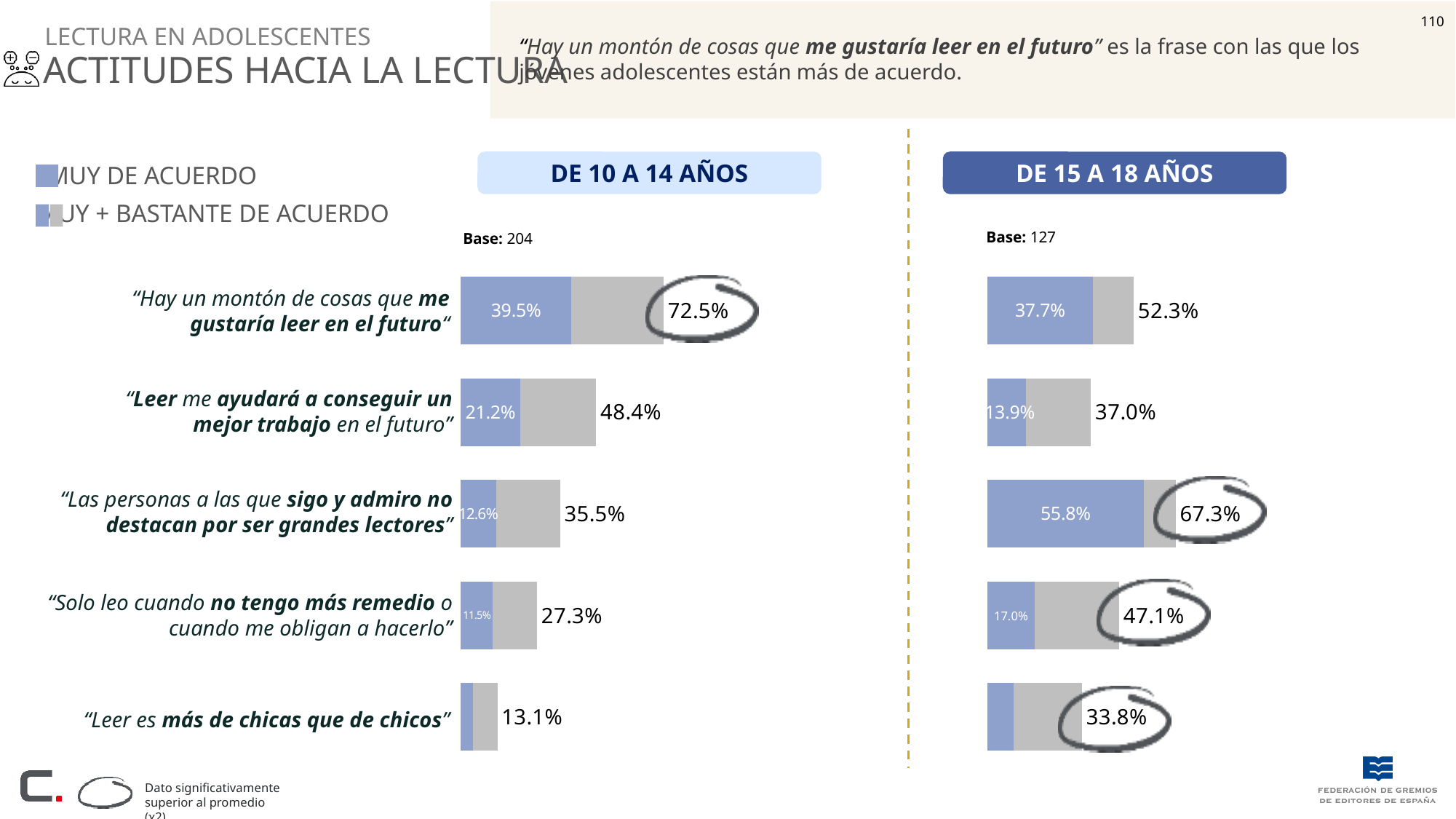
What is the difference between the 'Muy + bastante de acuerdo' values for "Hay un montón de cosas que me gustaría leer en el futuro" in the 'DE 10 A 14 AÑOS' chart and the 'DE 15 A 18 AÑOS' chart? 20.2 percentage points In the 'DE 10 A 14 AÑOS' chart, which statement has the highest 'Muy + bastante de acuerdo' value? "Hay un montón de cosas que me gustaría leer en el futuro" In the 'DE 10 A 14 AÑOS' chart, which statement has the lowest 'Muy + bastante de acuerdo' value? "Leer es más de chicas que de chicos" In the 'DE 10 A 14 AÑOS' chart, what is the 'Muy de acuerdo' value for "Leer me ayudará a conseguir un mejor trabajo en el futuro"? 21.2% In the 'DE 15 A 18 AÑOS' chart, what is the 'Muy de acuerdo' value for "Las personas a las que sigo y admiro no destacan por ser grandes lectores"? 55.8% What is the base (number of respondents) shown for the 'DE 15 A 18 AÑOS' chart? 127 How many statements are plotted in the 'DE 10 A 14 AÑOS' chart? 5 In the 'DE 15 A 18 AÑOS' chart, what is the 'Muy + bastante de acuerdo' value for "Leer es más de chicas que de chicos"? 33.8% In the 'DE 15 A 18 AÑOS' chart, which statement has the highest 'Muy + bastante de acuerdo' value? "Las personas a las que sigo y admiro no destacan por ser grandes lectores" How many series does the legend list? 2 In the 'DE 10 A 14 AÑOS' chart, what is the 'Muy + bastante de acuerdo' value for "Hay un montón de cosas que me gustaría leer en el futuro"? 72.5% Which chart shows a larger 'Muy + bastante de acuerdo' value for "Solo leo cuando no tengo más remedio o cuando me obligan a hacerlo": 'DE 10 A 14 AÑOS' or 'DE 15 A 18 AÑOS'? DE 15 A 18 AÑOS